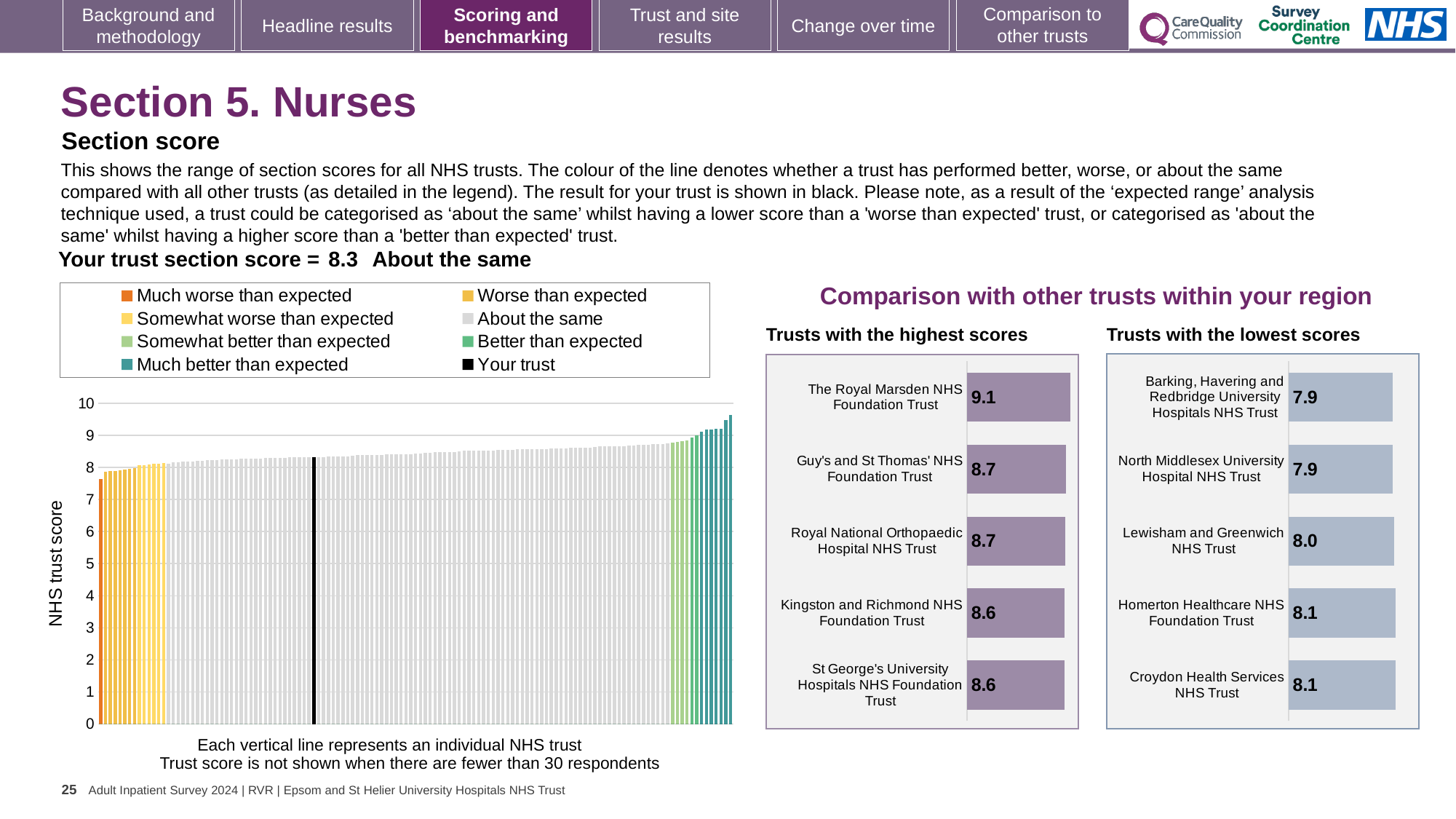
In the large chart on the left showing all NHS trusts, do the values rise or fall from left to right? rise In the 'Trusts with the highest scores' chart, which trust has the highest score? The Royal Marsden NHS Foundation Trust In the large chart on the left showing all NHS trusts, is the value of the tallest bar greater or less than 9? greater What kind of chart is the large chart on the left showing all NHS trusts? bar chart In the 'Trusts with the highest scores' chart, how many trusts are shown? 5 How many entries does the legend above the large chart on the left list? 8 In the 'Trusts with the highest scores' chart, what is the difference between the scores of The Royal Marsden NHS Foundation Trust and St George's University Hospitals NHS Foundation Trust? 0.5 In the 'Trusts with the lowest scores' chart, which has the larger score: Lewisham and Greenwich NHS Trust or North Middlesex University Hospital NHS Trust? Lewisham and Greenwich NHS Trust In the large chart on the left showing all NHS trusts, what is the section score for your trust (the black bar)? 8.3 In the 'Trusts with the lowest scores' chart, what is the score for Lewisham and Greenwich NHS Trust? 8.0 In the 'Trusts with the lowest scores' chart, what is the difference between the scores of Croydon Health Services NHS Trust and Barking, Havering and Redbridge University Hospitals NHS Trust? 0.2 In the 'Trusts with the highest scores' chart, what is the score for The Royal Marsden NHS Foundation Trust? 9.1